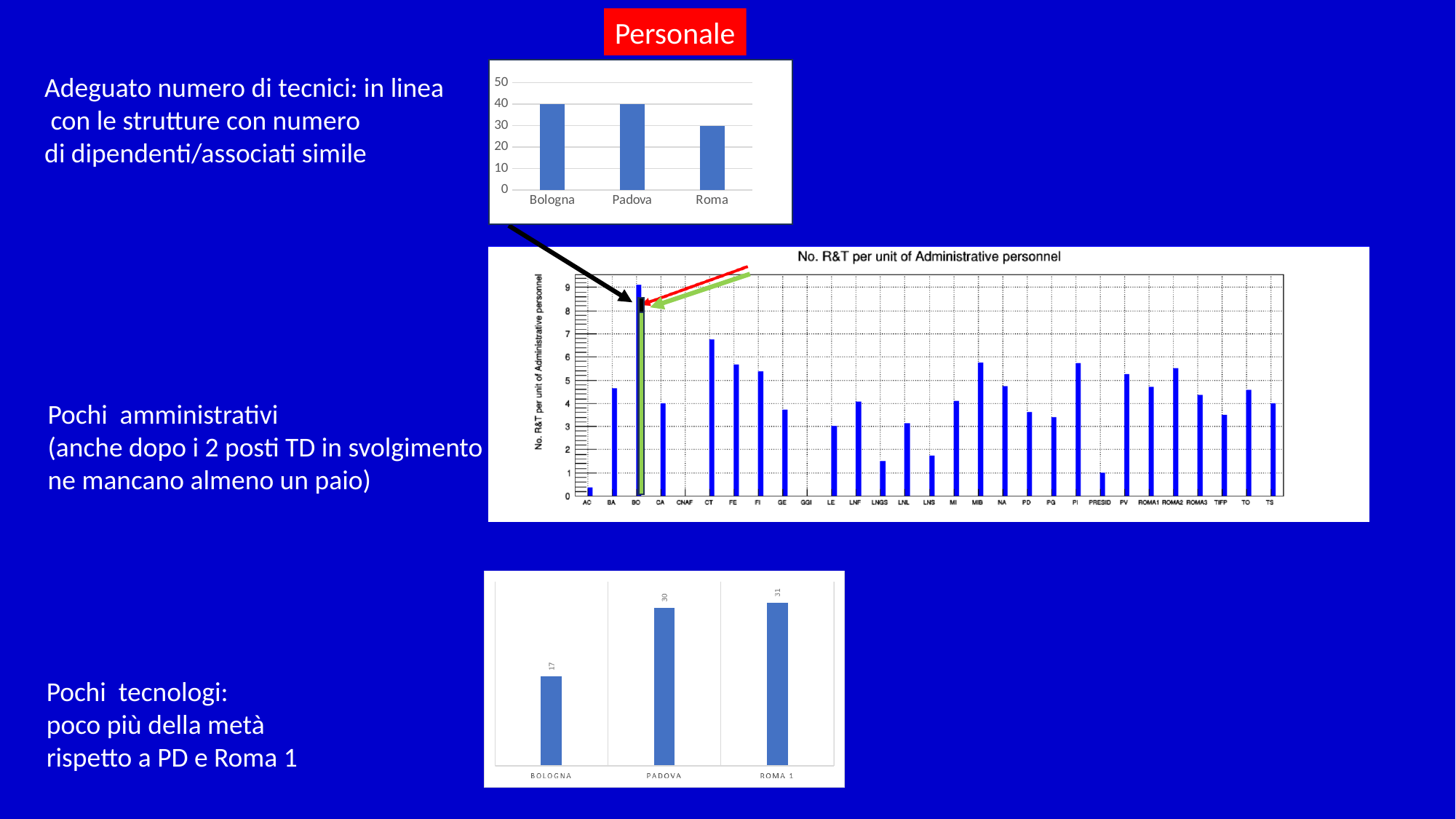
In the middle chart, is the value for CT greater or less than 6? greater What is the title of the middle chart? No. R&T per unit of Administrative personnel What kind of chart is the bottom chart? bar chart In the top chart, which category has the lowest value? Roma In the top chart, how many categories are shown? 3 In the bottom chart, what is the value for Bologna? 17 In the middle chart, is the value for LNGS greater or less than 2? less In the top chart, what is the value for Roma? 30 In the top chart, what is the value for Bologna? 40 In the middle chart, which category has the lowest value? AC In the middle chart, which category has the highest value? BO In the bottom chart, what is the difference between the values for Roma 1 and Bologna? 14